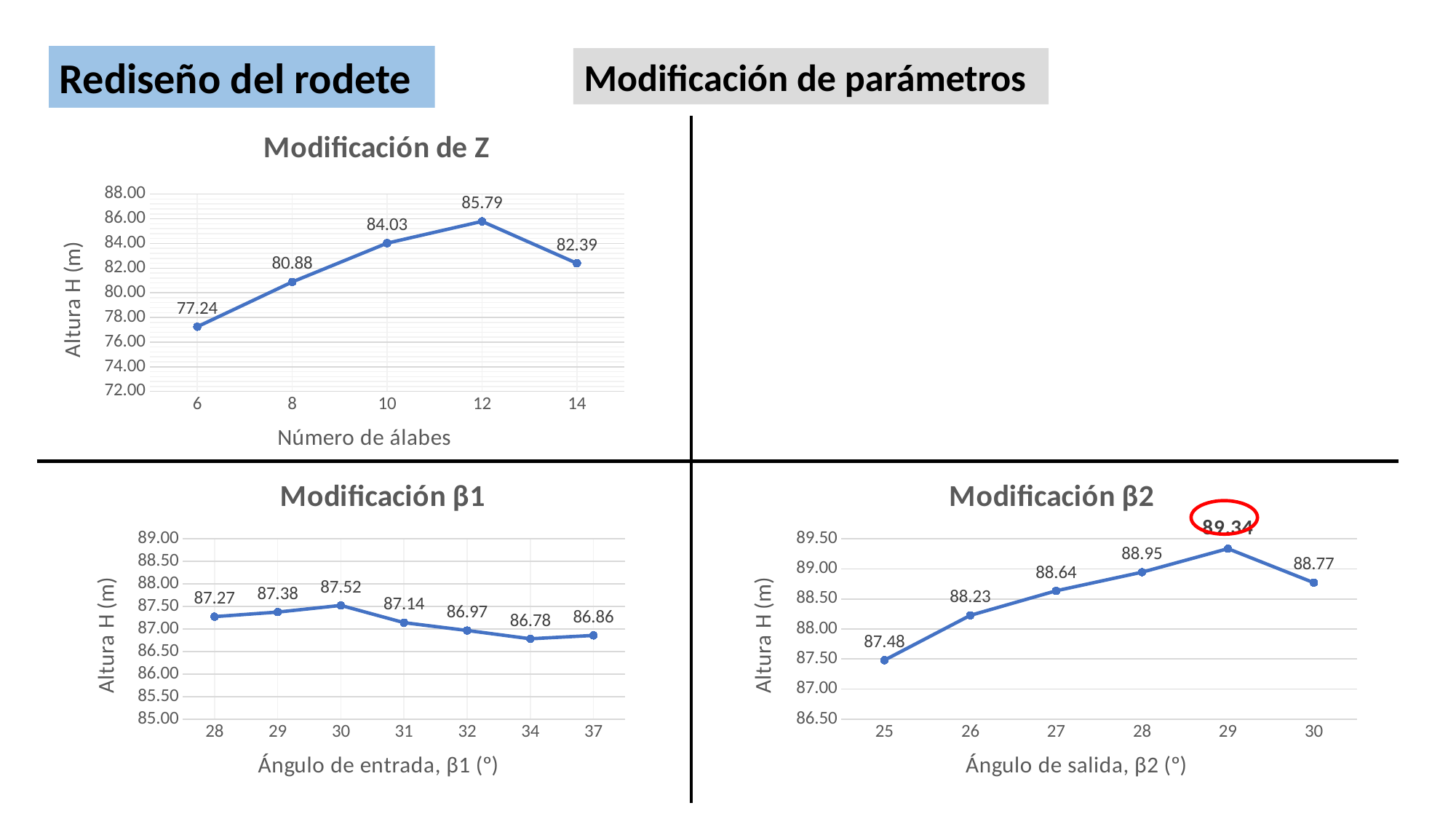
In the 'Modificación de Z' chart, what is the difference between the values at 12 and 14 blades? 3.40 In the 'Modificación de Z' chart, which number of blades gives the lowest Altura H? 6 In the 'Modificación β1' chart, which entry angle gives the lowest Altura H? 34 In the 'Modificación β2' chart, what is the Altura H value at an exit angle of 29°? 89.34 In the 'Modificación β2' chart, which exit angle gives the highest Altura H? 29 In the 'Modificación β1' chart, what is the Altura H value at an entry angle of 30°? 87.52 In the 'Modificación de Z' chart, what is the Altura H value when the number of blades is 12? 85.79 In the 'Modificación β1' chart, how many data points are plotted? 7 In the 'Modificación β2' chart, what is the difference between the values at 29° and 25°? 1.86 In the 'Modificación β2' chart, is the value at 25° larger or smaller than the value at 30°? smaller What type of chart is 'Modificación β2'? line chart In the 'Modificación de Z' chart, how many data points are plotted? 5